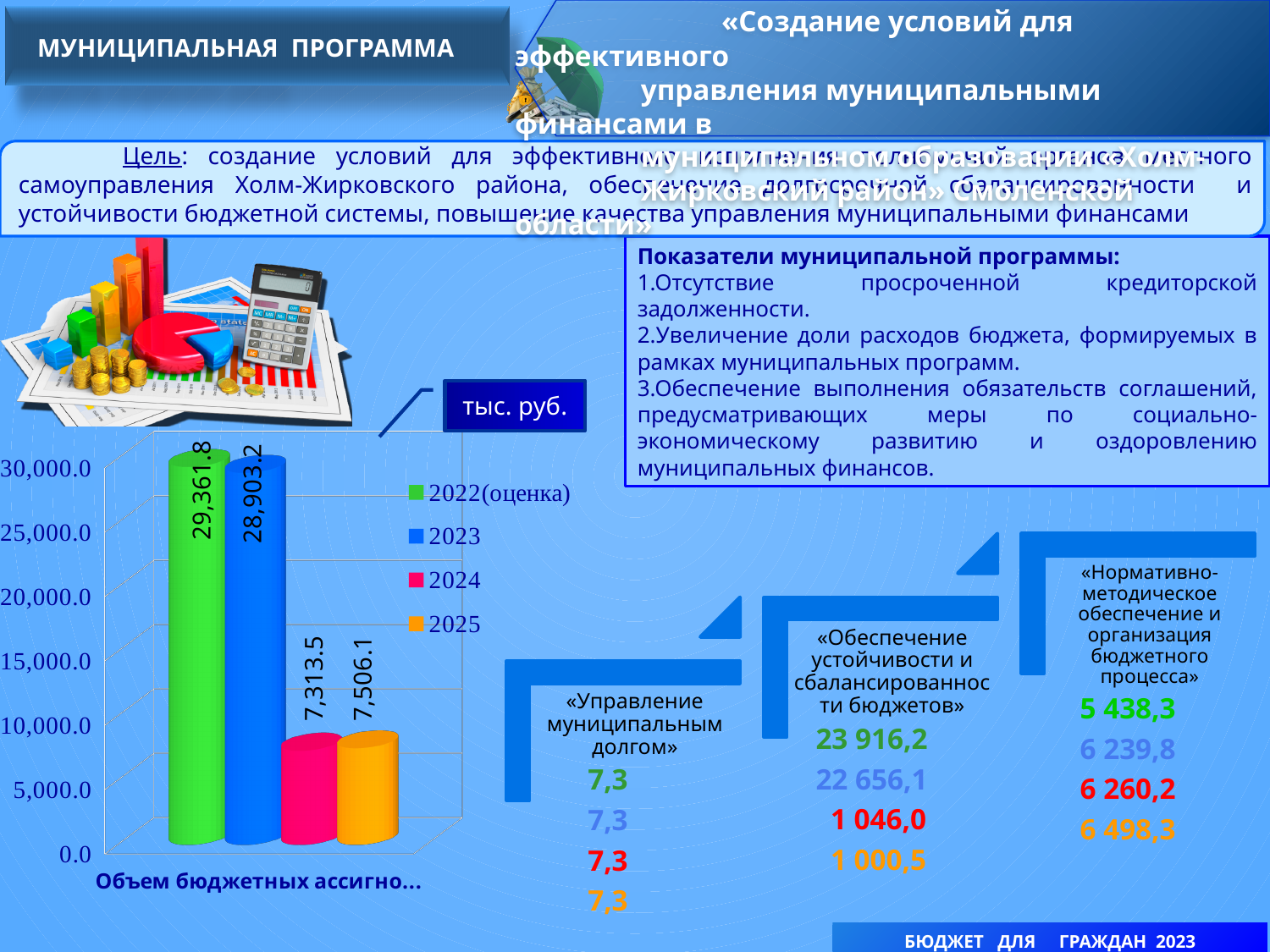
How many series does the chart legend list? 4 What is the difference between the 2025 value and the 2024 value? 192.6 Which series has the lowest value in the chart? 2024 What is the difference between the 2022(оценка) value and the 2023 value? 458.6 What unit is shown in the label above the chart? тыс. руб. What is the value for the 2024 series in the chart? 7,313.5 Which series has the highest value in the chart? 2022(оценка) What is the value for the 2025 series in the chart? 7,506.1 Which is larger, the value for 2023 or the value for 2025? 2023 Is the value for 2024 greater or less than 10,000.0? less What is the value for the 2023 series in the chart? 28,903.2 What is the value for the 2022(оценка) series in the chart? 29,361.8